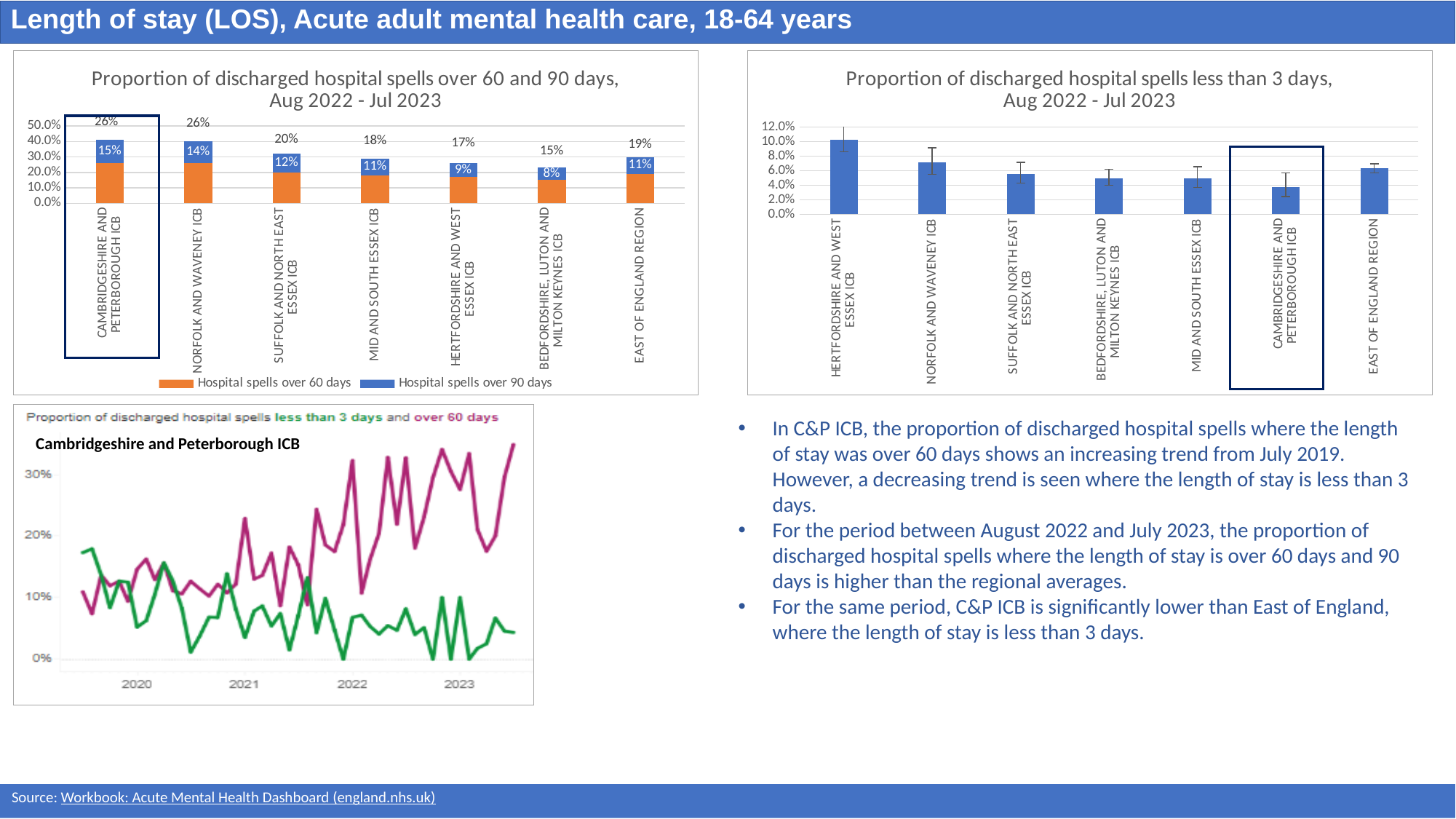
In the chart 'Proportion of discharged hospital spells over 60 and 90 days', how many series does the legend list? 2 In the bottom-left chart for Cambridgeshire and Peterborough ICB, what kind of chart is it? Line chart In the chart 'Proportion of discharged hospital spells less than 3 days', is the value for Hertfordshire and West Essex ICB greater or less than 8.0%? greater In the chart 'Proportion of discharged hospital spells less than 3 days', which category has the lowest value? Cambridgeshire and Peterborough ICB In the chart 'Proportion of discharged hospital spells over 60 and 90 days', what is the difference between the over-90-days values for Cambridgeshire and Peterborough ICB and East of England Region? 4% In the chart 'Proportion of discharged hospital spells over 60 and 90 days', what is the value for hospital spells over 90 days for Cambridgeshire and Peterborough ICB? 15% In the chart 'Proportion of discharged hospital spells less than 3 days', which category has the highest value? Hertfordshire and West Essex ICB In the chart 'Proportion of discharged hospital spells less than 3 days', is the value for Cambridgeshire and Peterborough ICB greater or less than 6.0%? less In the chart 'Proportion of discharged hospital spells over 60 and 90 days', which colour represents hospital spells over 60 days? Orange In the chart 'Proportion of discharged hospital spells less than 3 days', how many categories are shown on the x axis? 7 In the chart 'Proportion of discharged hospital spells over 60 and 90 days', which ICB has the lowest value for hospital spells over 90 days? Bedfordshire, Luton and Milton Keynes ICB In the chart 'Proportion of discharged hospital spells over 60 and 90 days', what is the value for hospital spells over 90 days for Bedfordshire, Luton and Milton Keynes ICB? 8%